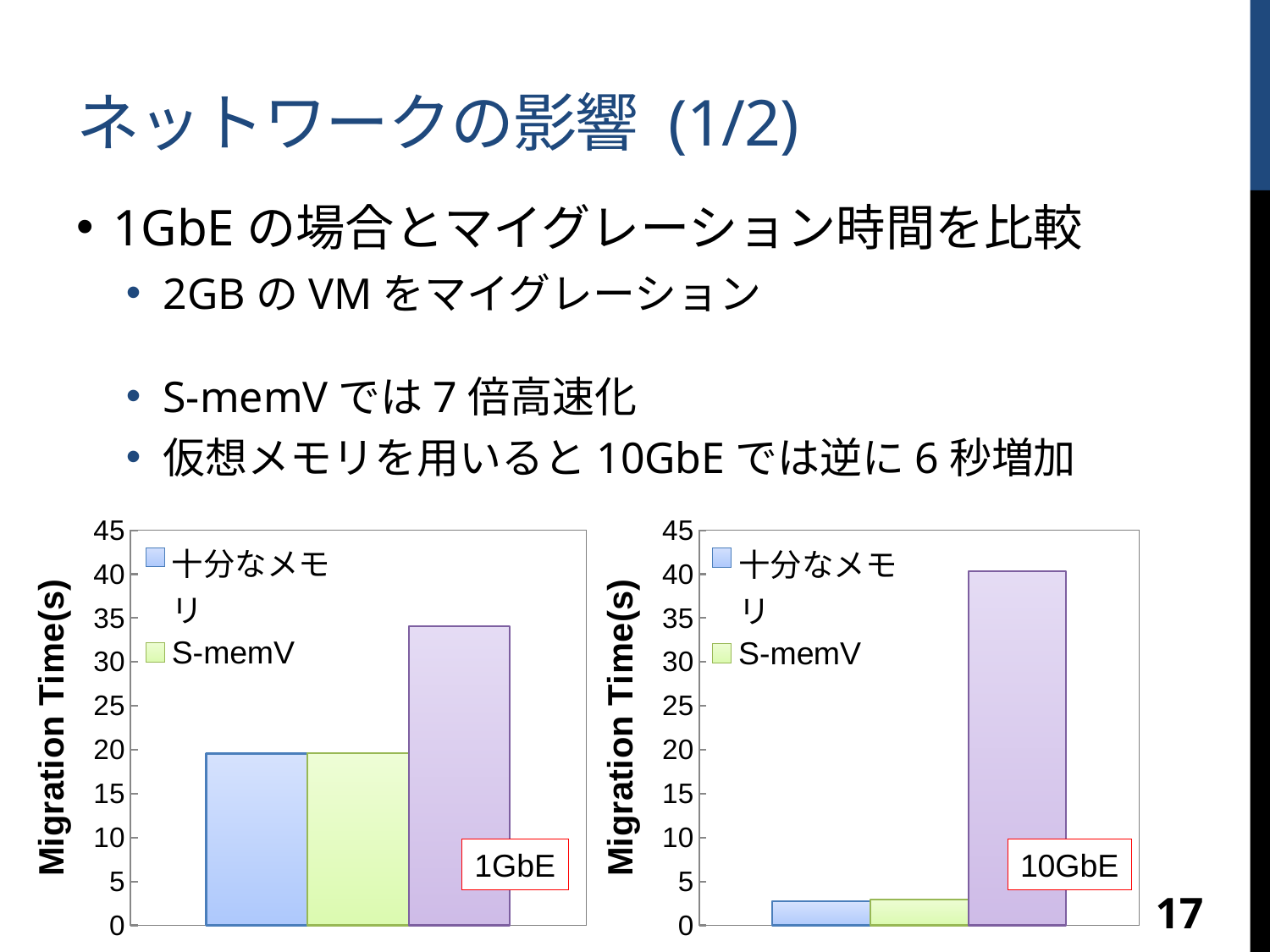
In the 1GbE chart, is the value for S-memV greater or less than 25? less What is the y-axis label of the 10GbE chart? Migration Time(s) In the 1GbE chart, is the value of the purple (rightmost) bar greater or less than 30? greater What kind of chart is the 1GbE chart on the left? bar chart In the 10GbE chart, is the value for 十分なメモリ greater or less than 5? less In the 10GbE chart, how many series does the visible legend list? 2 In the 1GbE chart, what colour is the S-memV bar? green In the 1GbE chart, how many bars are plotted? 3 In the 1GbE chart, which is larger: the S-memV bar or the purple (rightmost) bar? the purple (rightmost) bar In the 10GbE chart, which bar is the highest? the purple (rightmost) bar